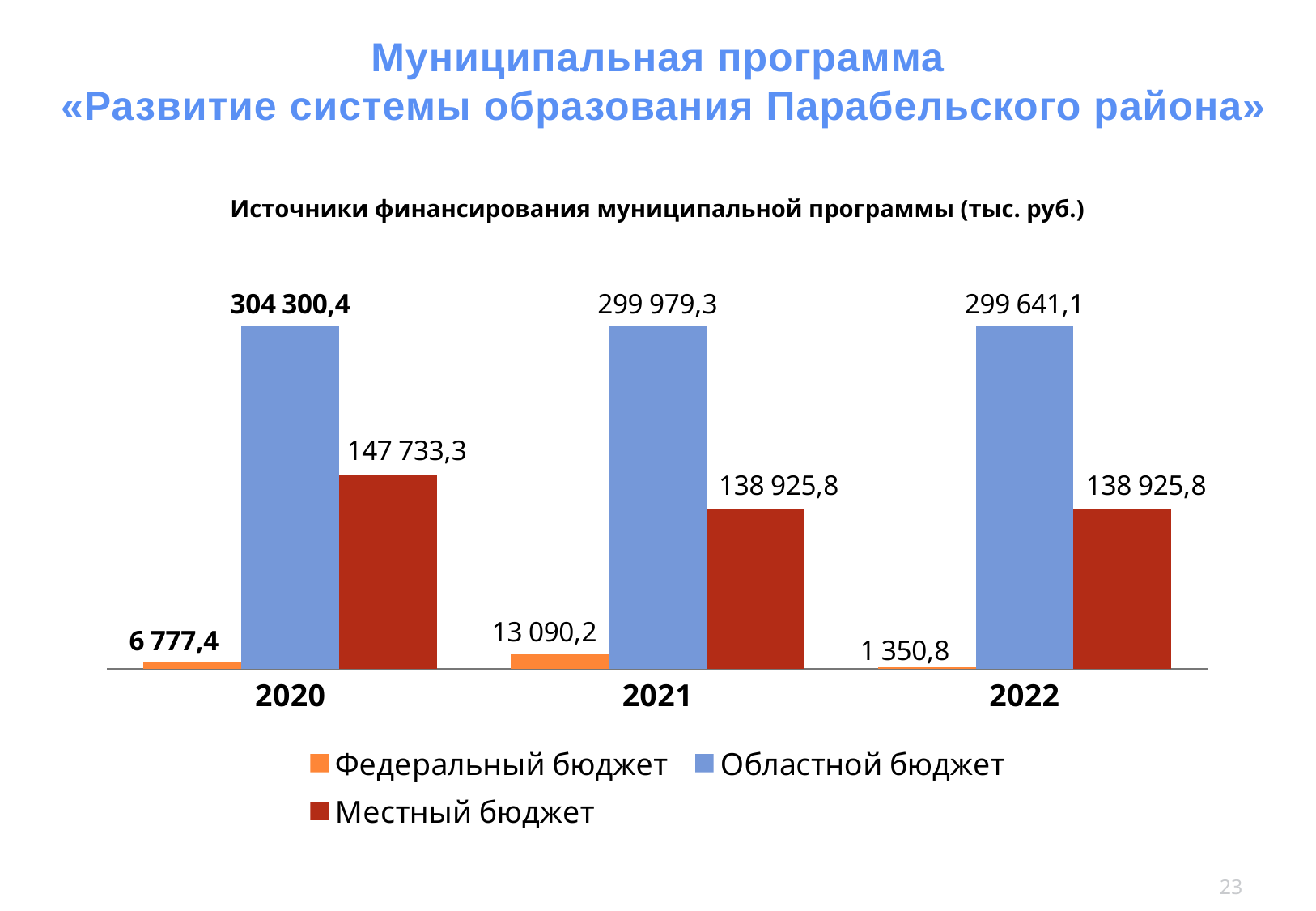
In which year is the Федеральный бюджет value the lowest? 2022 How many years are shown on the x axis? 3 What is the value for Федеральный бюджет in 2022? 1 350,8 What is the difference between the Местный бюджет values for 2020 and 2021? 8 807,5 What is the difference between the Областной бюджет values for 2020 and 2021? 4 321,1 What is the value for Местный бюджет in 2022? 138 925,8 In which year is the Федеральный бюджет value the highest? 2021 What is the value for Федеральный бюджет in 2021? 13 090,2 What is the value for Областной бюджет in 2020? 304 300,4 Does the Областной бюджет value rise or fall from 2020 to 2022? fall How many series does the legend list? 3 Which is larger in 2021: Областной бюджет or Местный бюджет? Областной бюджет